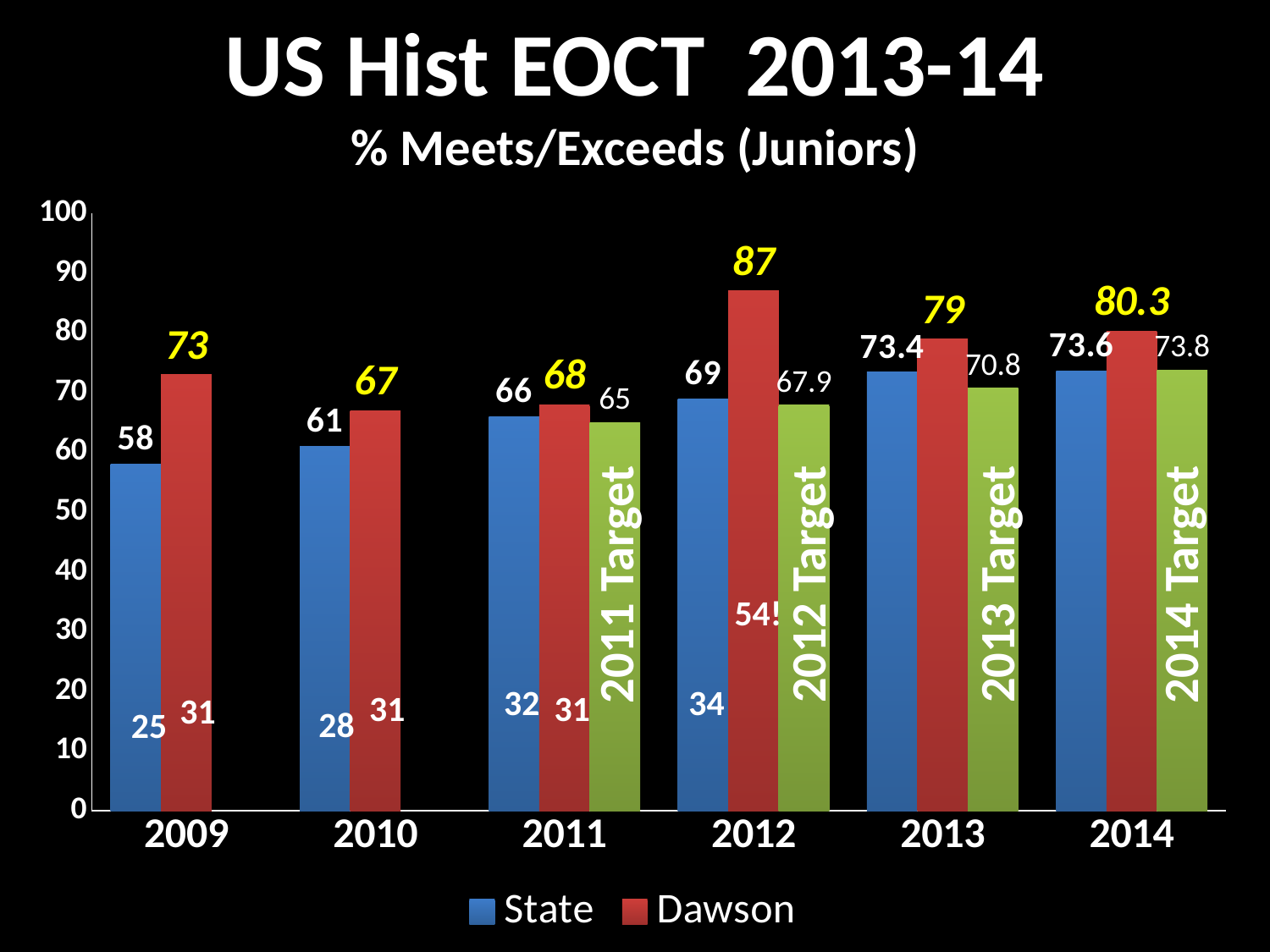
Which is larger in 2010, the State value or the Dawson value? Dawson What is the State value for 2014? 73.6 How many years are shown on the x axis? 6 In which year is the Dawson value highest? 2012 What is the 2013 Target value? 70.8 What is the Dawson value for 2012? 87 What is the difference between the Dawson and State values in 2009? 15 Do the State values rise or fall from 2009 to 2014? rise What kind of chart is shown? bar chart In which year is the State value lowest? 2009 Is the Dawson value for 2014 greater or less than 80? greater How many series does the legend list? 2